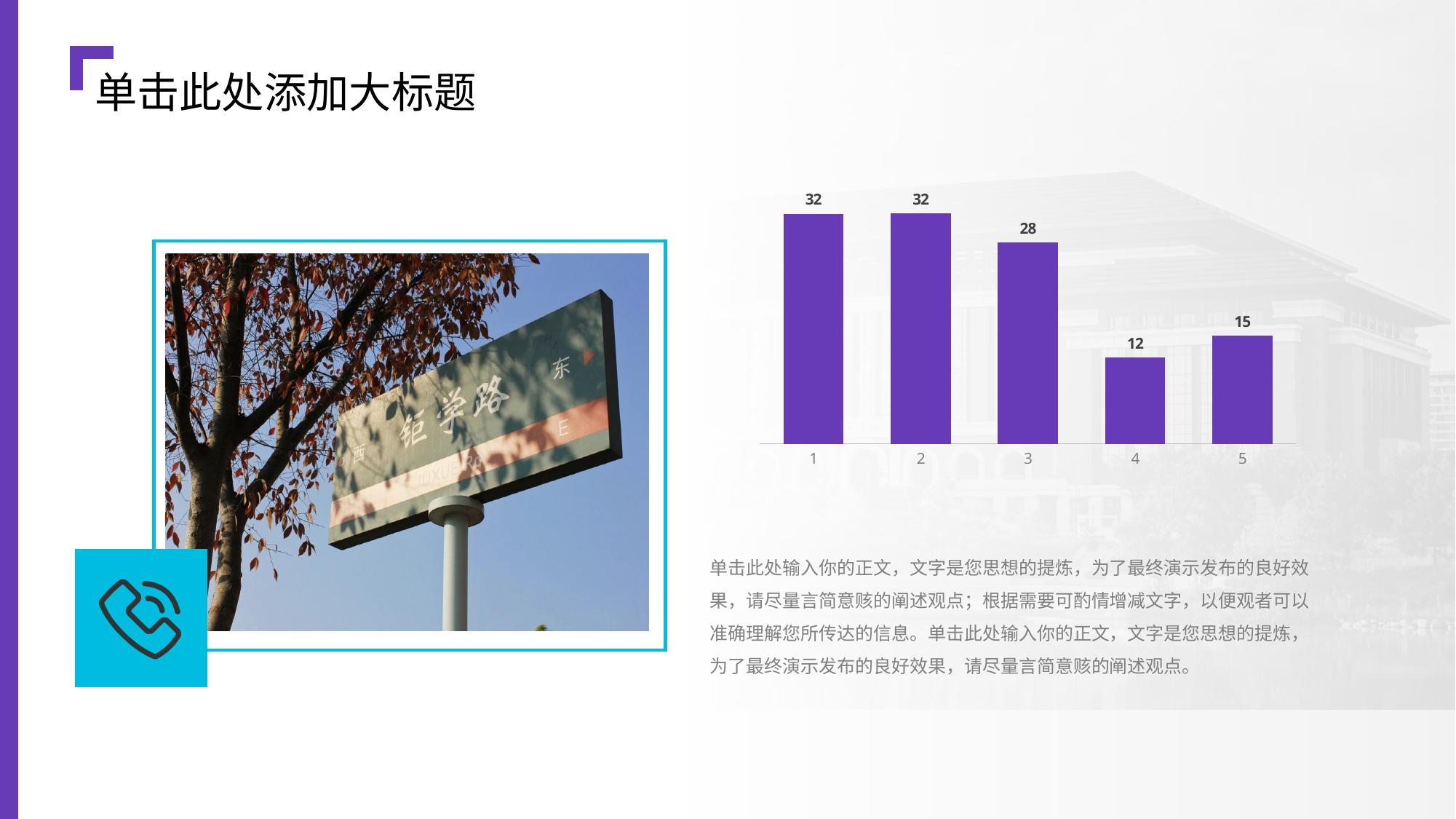
What is the difference between the values for category 3 and category 4? 16 What is the value for category 1? 32 What is the difference between the values for category 1 and category 5? 17 What colour are the bars in the chart? purple Which is larger, the value for category 4 or the value for category 5? 5 Which category has the lowest value? 4 What is the value for category 4? 12 How many categories are shown on the x axis? 5 What is the value for category 5? 15 What kind of chart is shown on the slide? bar chart Do the values generally rise or fall from category 1 to category 4? fall What is the value for category 3? 28